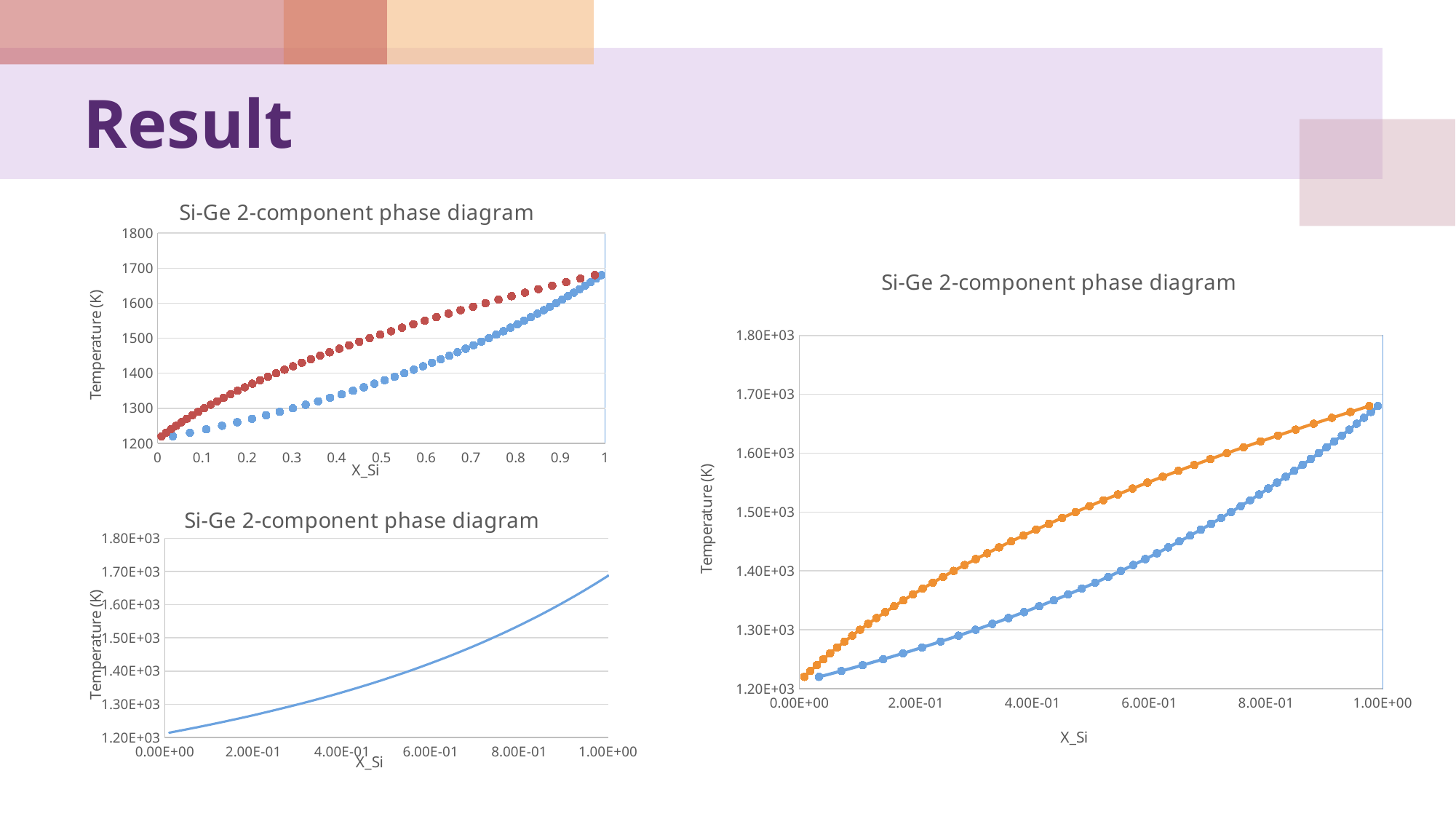
What is the title of the right-hand chart? Si-Ge 2-component phase diagram In the right-hand chart, is the value of the blue series at X_Si = 4.00E-01 greater or less than 1.40E+03? less What is the y-axis label of the bottom-left chart? Temperature (K) In the bottom-left chart, does the temperature rise or fall as X_Si increases? rise In the top-left chart, do the temperature values rise or fall as X_Si increases from 0 to 1? rise In the right-hand chart, is the value of the orange series at X_Si = 4.00E-01 greater or less than 1.40E+03? greater In the top-left chart, is the value of the blue series at X_Si = 0.4 greater or less than 1400? less In the right-hand chart, at X_Si = 6.00E-01, which series has the higher temperature, the orange or the blue? orange What kind of chart is the bottom-left chart on the slide? line chart In the top-left chart, at X_Si = 0.5, which series has the higher temperature, the red or the blue? red What kind of chart is the top-left chart on the slide? scatter chart